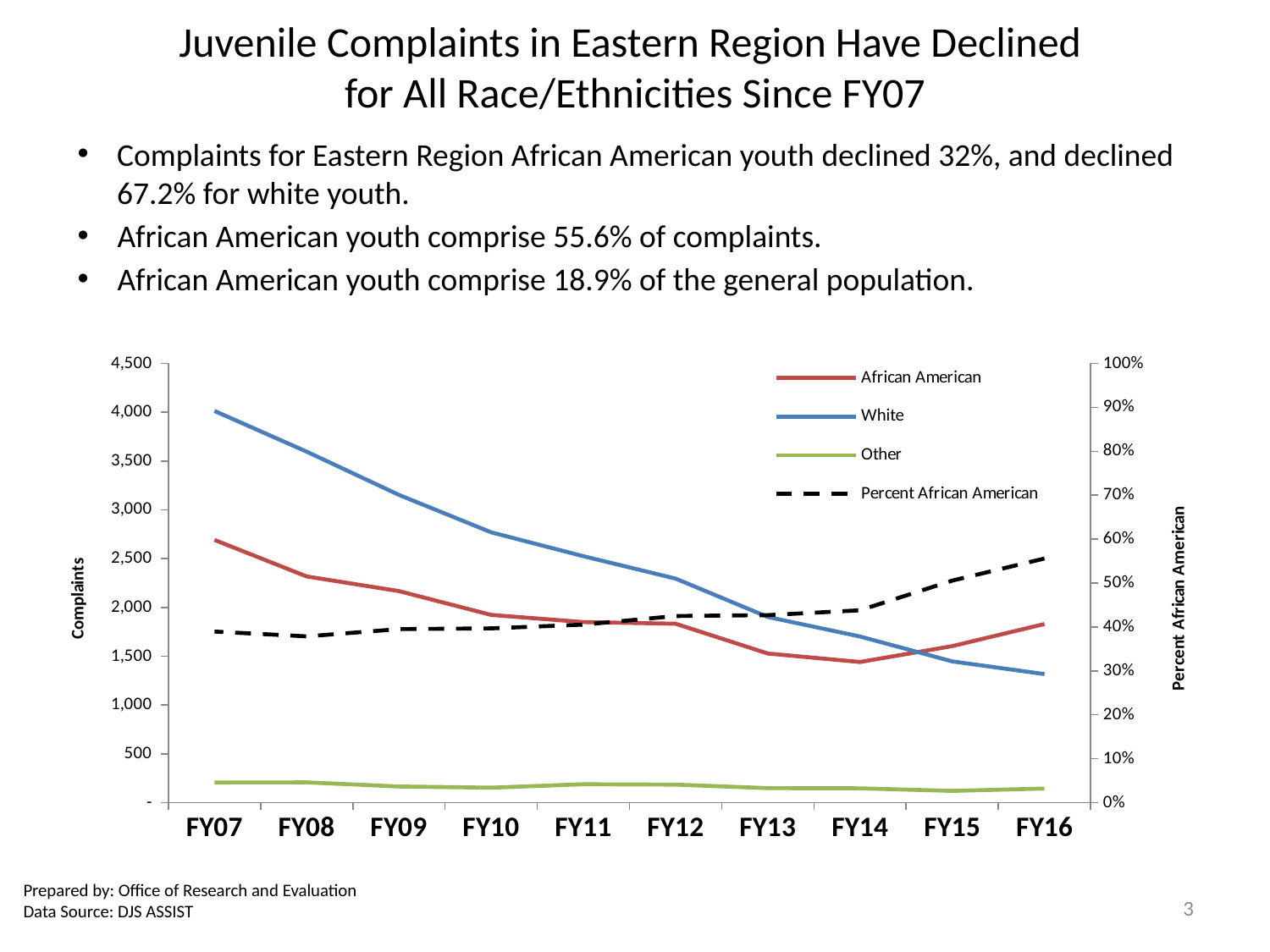
Is the value for African American complaints in FY07 greater or less than 2,500? greater How many fiscal years are plotted along the x axis? 10 Is the value for Percent African American in FY16 greater or less than 50%? greater Is the value for White complaints in FY07 greater or less than 3,500? greater Do White complaints rise or fall from FY07 to FY16? fall Which series had more complaints in FY07, White or African American? White Which series had more complaints in FY16, White or African American? African American Which series is drawn as a dashed line? Percent African American How many series does the chart legend list? 4 What kind of chart is shown on the slide? line chart